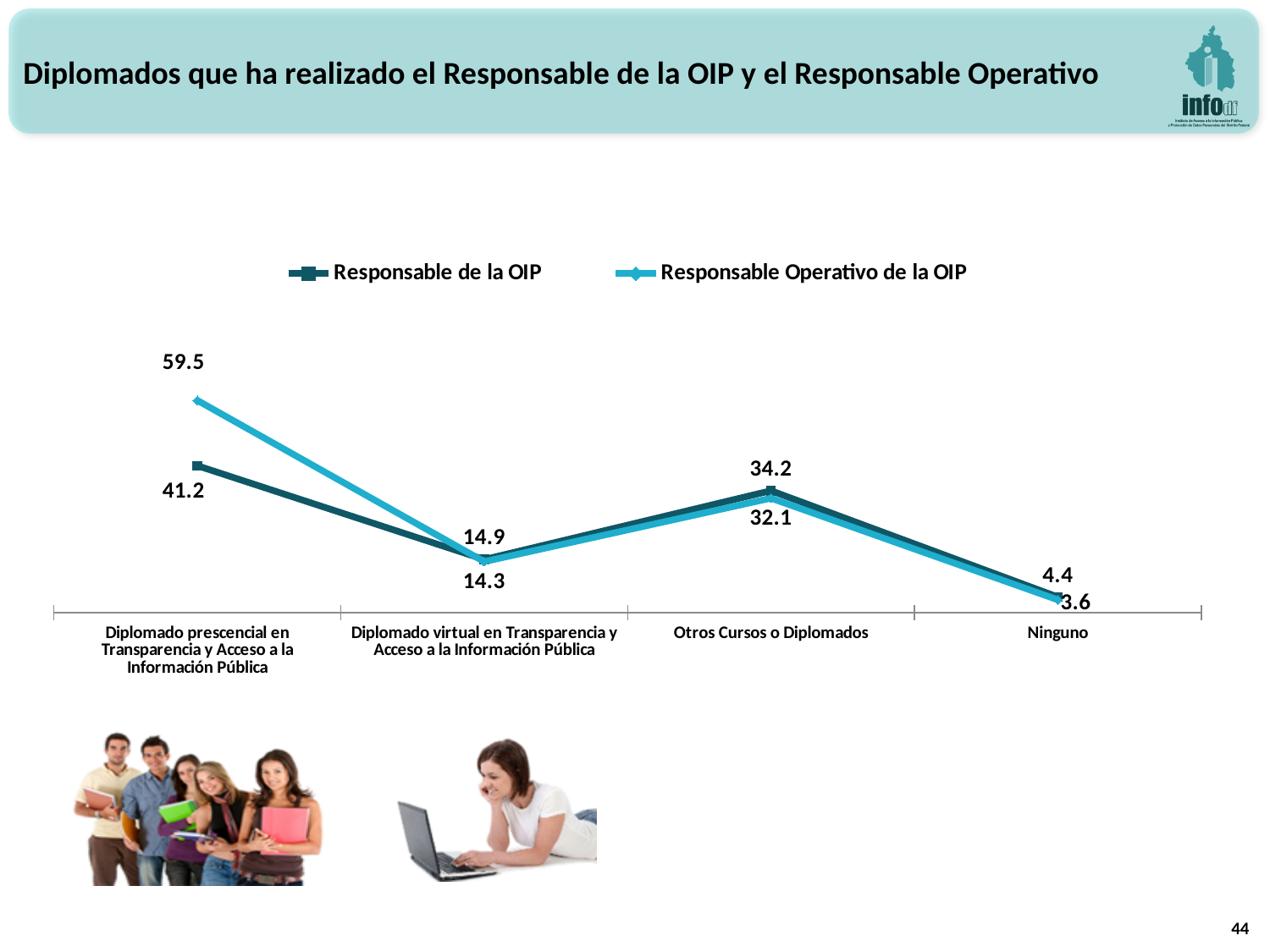
What is the value for Responsable Operativo de la OIP for 'Ninguno'? 3.6 What is the difference between the Responsable Operativo de la OIP and Responsable de la OIP values for 'Diplomado prescencial en Transparencia y Acceso a la Información Pública'? 18.3 What type of chart is shown on the slide? Line chart How many categories are shown along the x axis? 4 What is the value for Responsable de la OIP for 'Ninguno'? 4.4 What is the value for Responsable de la OIP for 'Otros Cursos o Diplomados'? 34.2 What is the value for Responsable Operativo de la OIP for 'Diplomado prescencial en Transparencia y Acceso a la Información Pública'? 59.5 What is the value for Responsable de la OIP for 'Diplomado prescencial en Transparencia y Acceso a la Información Pública'? 41.2 What is the value for Responsable Operativo de la OIP for 'Otros Cursos o Diplomados'? 32.1 How many series does the legend list? 2 Which category has the highest value for Responsable Operativo de la OIP? Diplomado prescencial en Transparencia y Acceso a la Información Pública For 'Otros Cursos o Diplomados', which series has the larger value? Responsable de la OIP